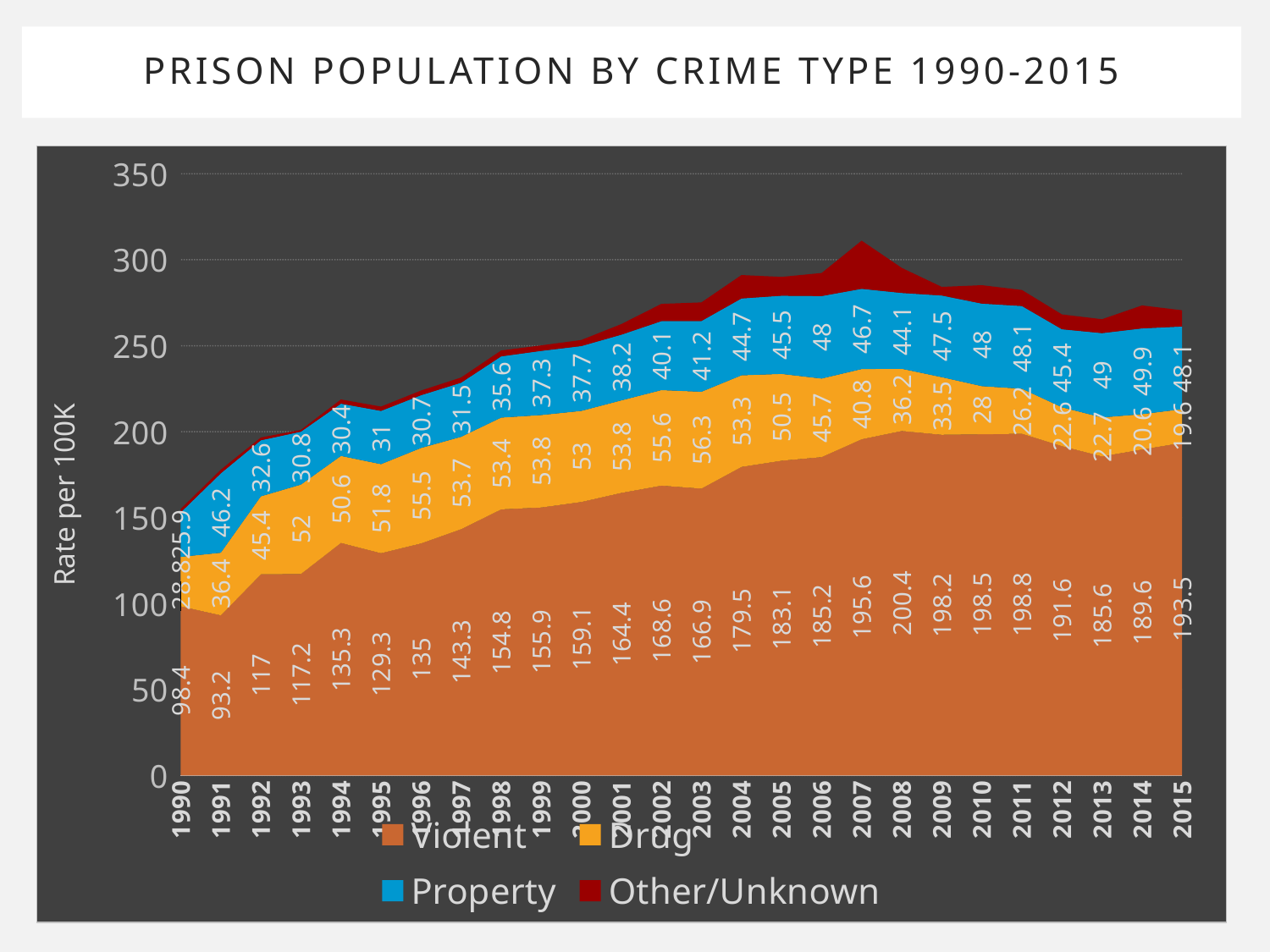
What is the Property rate per 100K in 2014? 49.9 What is the Drug rate per 100K in 2003? 56.3 What kind of chart is shown on the slide? Stacked area chart Which is larger, the Drug rate in 1993 or the Drug rate in 2010? 1993 In which year is the Violent series at its lowest? 1991 How many series does the legend list? 4 Does the Drug series rise or fall from 2003 to 2015? Fall What is the Violent rate per 100K in 2008? 200.4 What is the label on the y axis? Rate per 100K In which year is the Violent series at its highest? 2008 What is the difference between the Violent rate in 2015 and in 1990? 95.1 How many years are shown on the x axis? 26